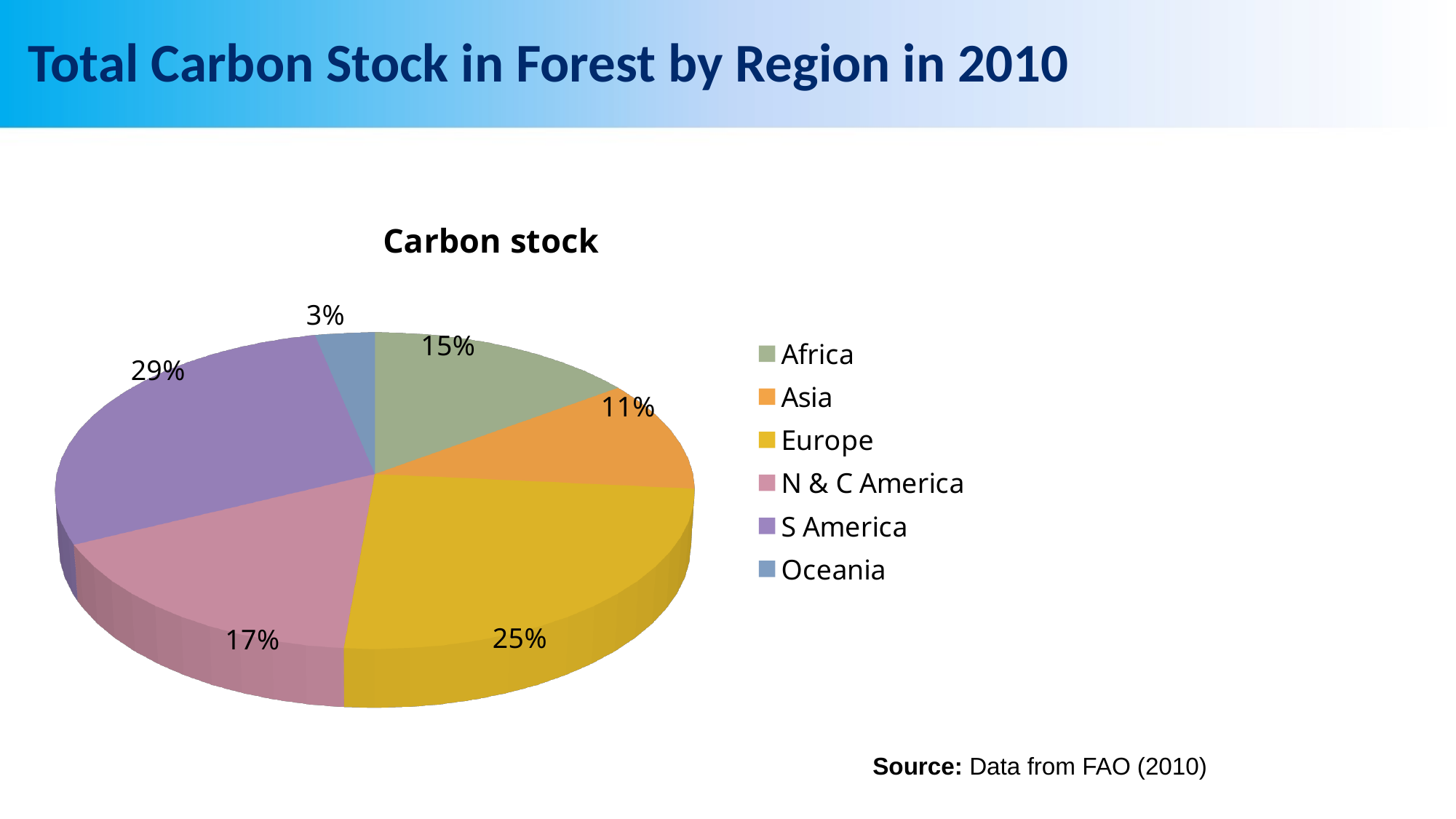
Which region is shown in yellow in the pie chart? Europe What is the chart's title? Carbon stock How many regions are shown in the pie chart? 6 What share of the carbon stock does Europe hold? 25% What share of the carbon stock does Oceania hold? 3% Which region has the largest share of carbon stock? S America What share of the carbon stock does Asia hold? 11% What share of the carbon stock does S America hold? 29% Which region has the smallest share of carbon stock? Oceania Which has a larger share of carbon stock, Africa or N & C America? N & C America What kind of chart is shown on the slide? pie chart What is the difference in percentage points between the shares of S America and Europe? 4